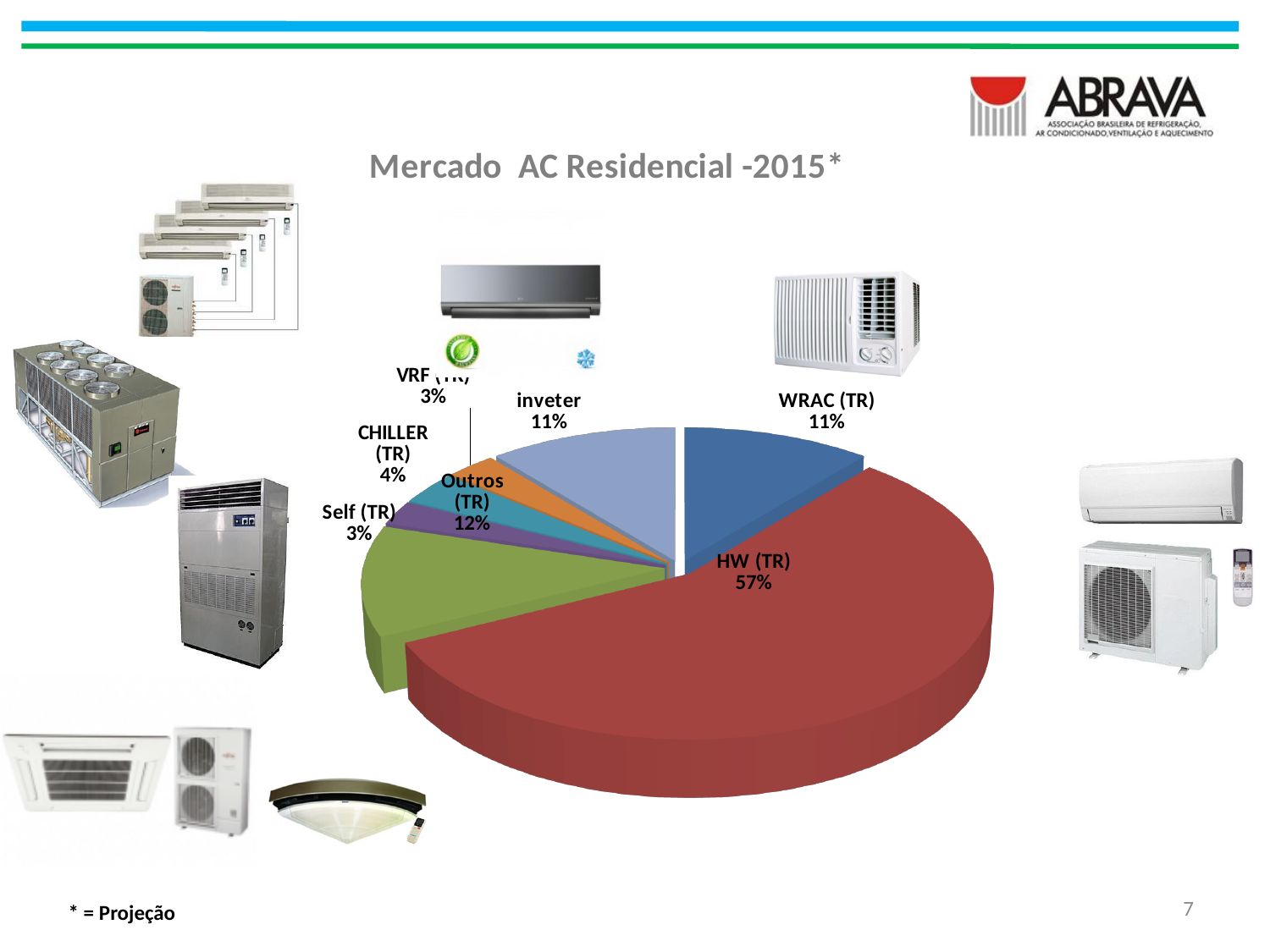
What is the value shown for WRAC (TR)? 11% What is the title of the chart? Mercado AC Residencial -2015* What percentage is shown for Outros (TR)? 12% What is the value shown for the inveter slice? 11% What percentage is labelled for Self (TR)? 3% Which is larger, the HW (TR) slice or the WRAC (TR) slice? HW (TR) What kind of chart is shown on the slide? Pie chart What share of the pie does HW (TR) represent? 57% What is the value for CHILLER (TR)? 4% What is the difference in percentage points between HW (TR) and WRAC (TR)? 46 Which category has the largest slice of the pie? HW (TR) How many slices does the pie chart have? 7